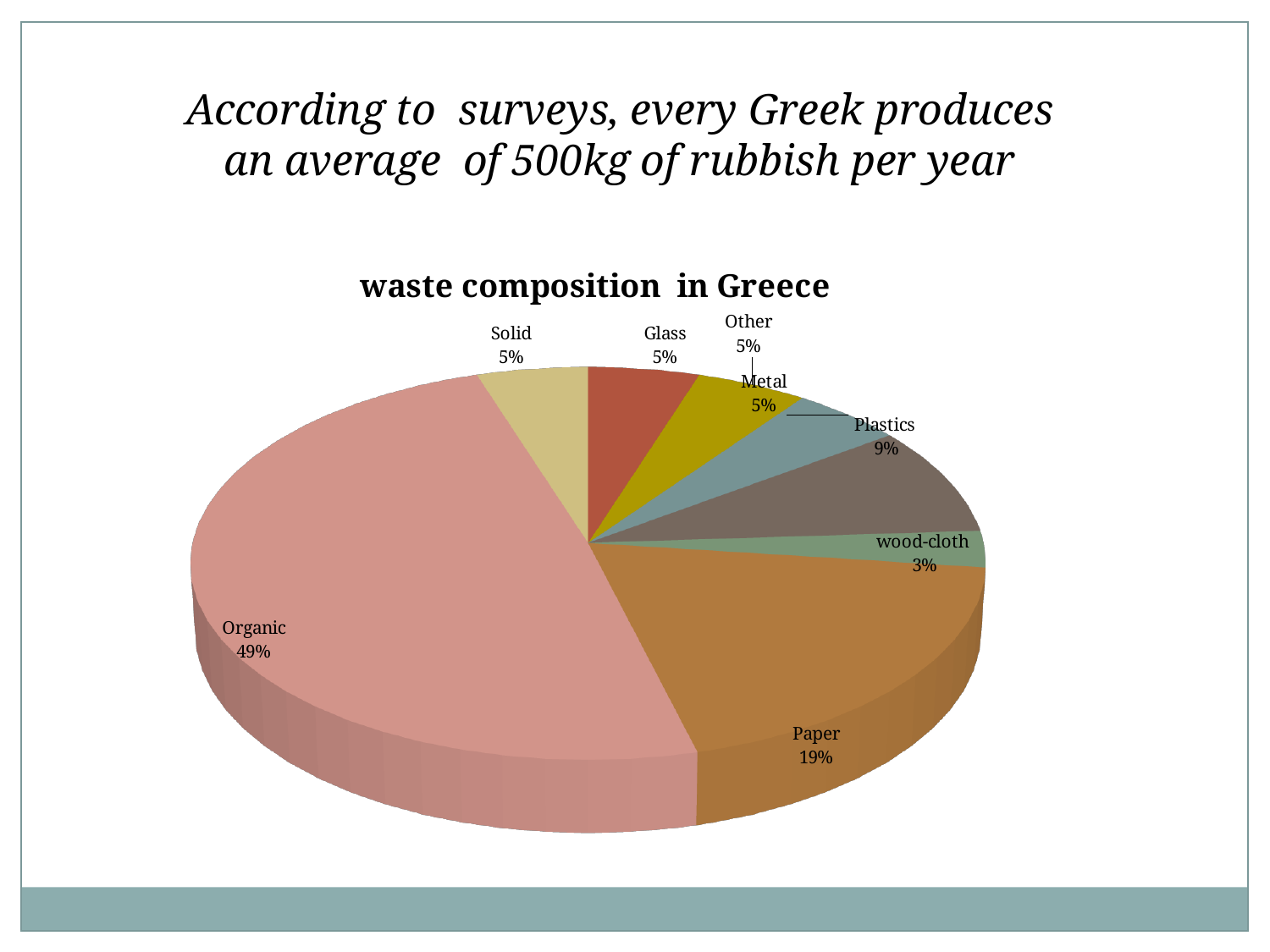
What percentage of the pie is Paper? 19% What percentage does wood-cloth account for? 3% What type of chart is shown on the slide? Pie chart What is the share for Metal? 5% Which category has the largest slice of the pie? Organic What is the title of the chart? waste composition in Greece How many categories are shown in the pie chart? 8 What share of waste composition in Greece is Organic? 49% Which is larger, the Plastics slice or the Glass slice? Plastics What is the difference in percentage points between Organic and Paper? 30 What is the share for Plastics? 9% Which category has the smallest slice of the pie? wood-cloth